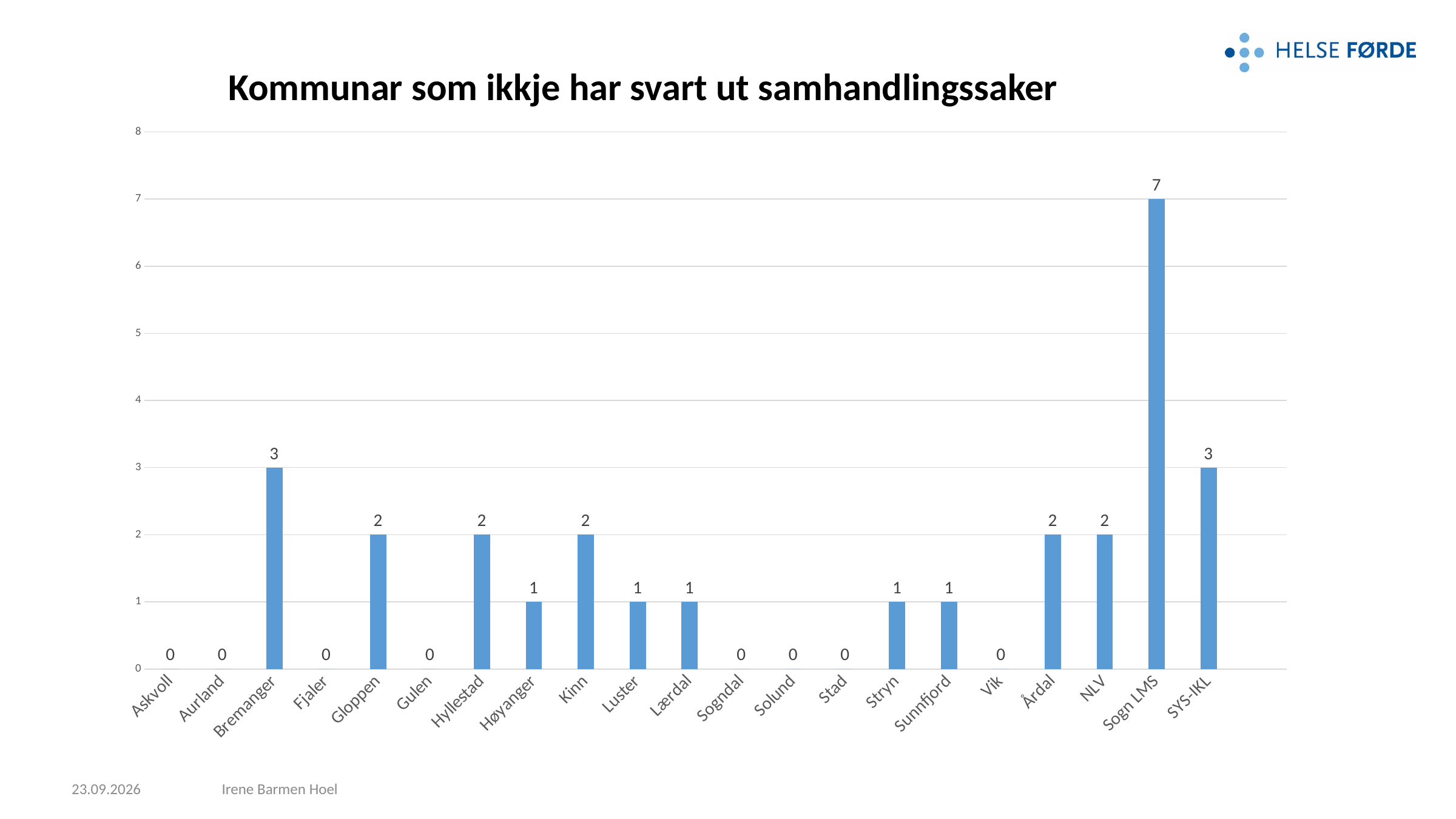
What kind of chart is shown on the slide? bar chart How many categories are shown on the x axis? 21 What is the title of the chart? Kommunar som ikkje har svart ut samhandlingssaker What is the value for Sogn LMS? 7 What is the difference between the values for Sogn LMS and SYS-IKL? 4 What is the value for Sogndal? 0 What is the value for Høyanger? 1 What is the difference between the values for Gloppen and Luster? 1 Which category has the highest value? Sogn LMS What is the value for Bremanger? 3 Which is larger, the value for Årdal or the value for Stryn? Årdal Is the value for Sogn LMS greater or less than 5? greater